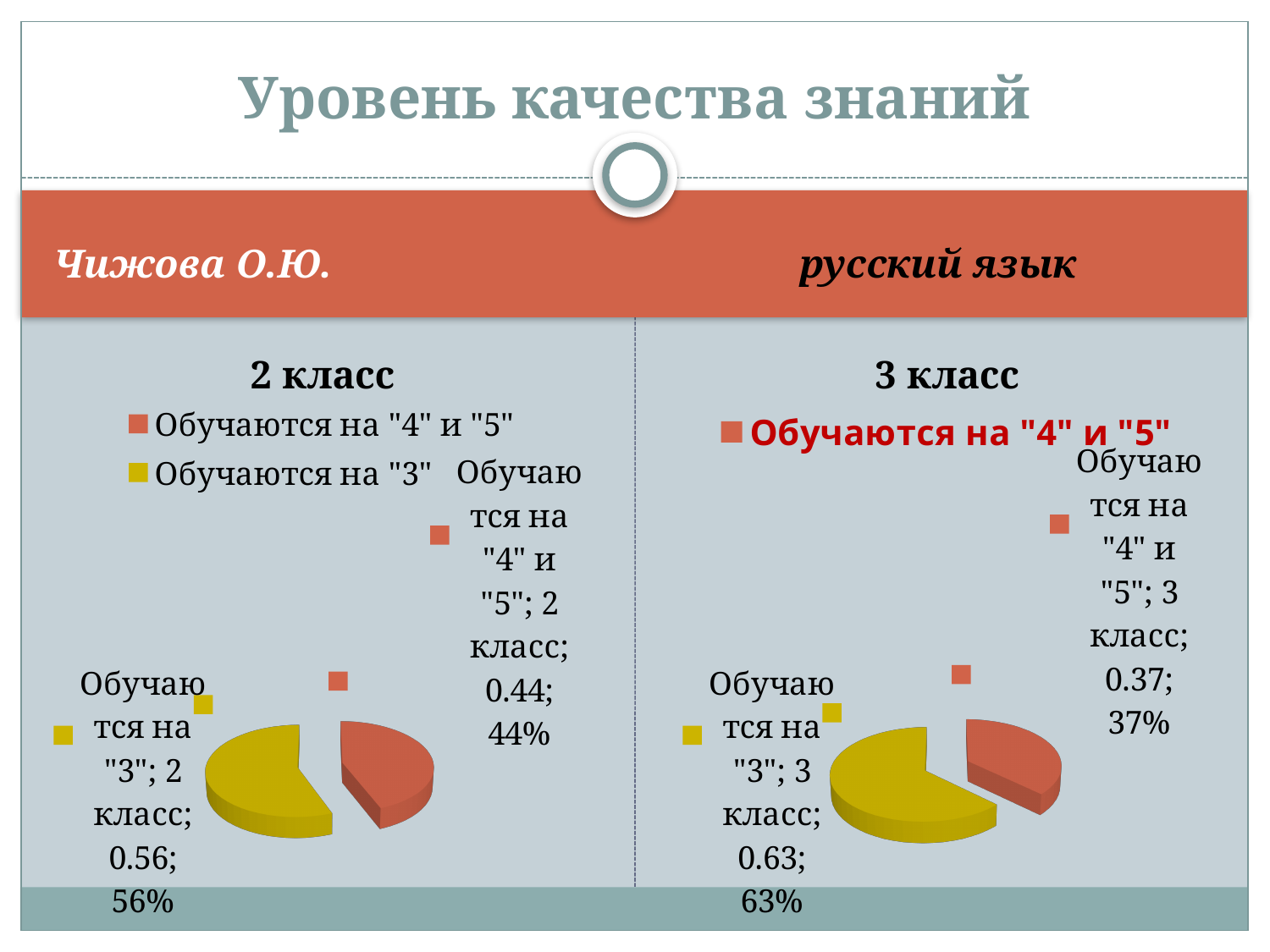
In the "2 класс" chart, what share of the pie is labelled Обучаются на "3"? 56% In the "3 класс" chart, what is the difference in percentage points between the Обучаются на "3" slice and the Обучаются на "4" и "5" slice? 26 What type of chart is the "2 класс" chart? pie chart In the "2 класс" chart, what share of the pie is labelled Обучаются на "4" и "5"? 44% What colour is the Обучаются на "3" slice in the "3 класс" chart? yellow In the "3 класс" chart, what share of the pie is labelled Обучаются на "3"? 63% In the "3 класс" chart, which slice is the smallest? Обучаются на "4" и "5" Which chart has the larger share for Обучаются на "4" и "5": "2 класс" or "3 класс"? 2 класс How many entries does the legend of the "2 класс" chart list? 2 How many slices does the "2 класс" pie chart have? 2 In the "2 класс" chart, which slice is the largest? Обучаются на "3"